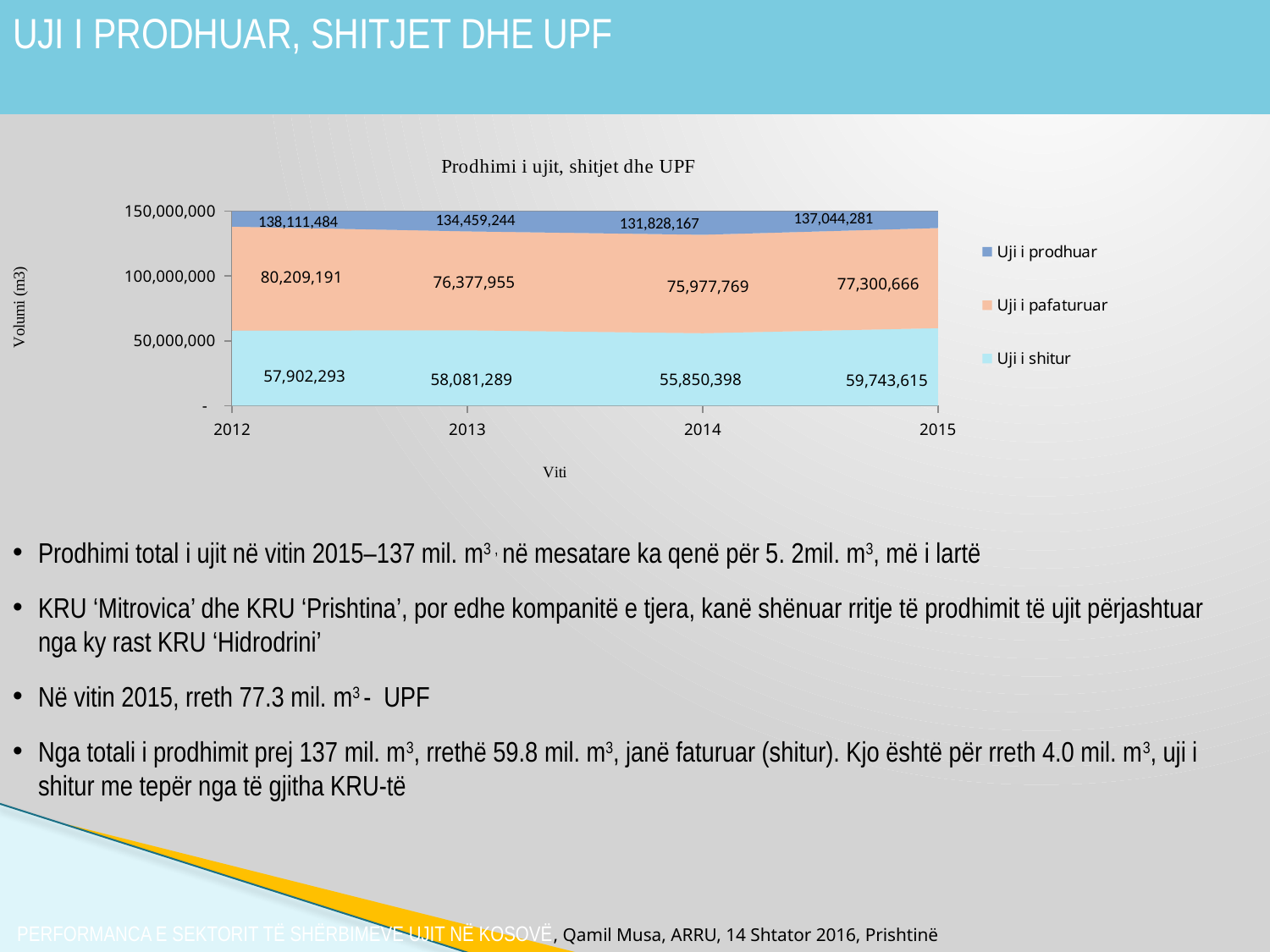
What is the value of Uji i pafaturuar in 2013? 76,377,955 In which year is Uji i prodhuar highest? 2012 Which is larger: Uji i shitur in 2013 or Uji i shitur in 2015? Uji i shitur in 2015 What is the value of Uji i shitur in 2014? 55,850,398 What is the difference between Uji i pafaturuar in 2012 and in 2015? 2,908,525 What is the title of the chart? Prodhimi i ujit, shitjet dhe UPF How many years are shown on the x axis of the chart? 4 How many series does the chart legend list? 3 What is the label of the y axis of the chart? Volumi (m3) What kind of chart is shown on the slide? Area chart What is the value of Uji i prodhuar in 2015? 137,044,281 In which year is Uji i shitur lowest? 2014